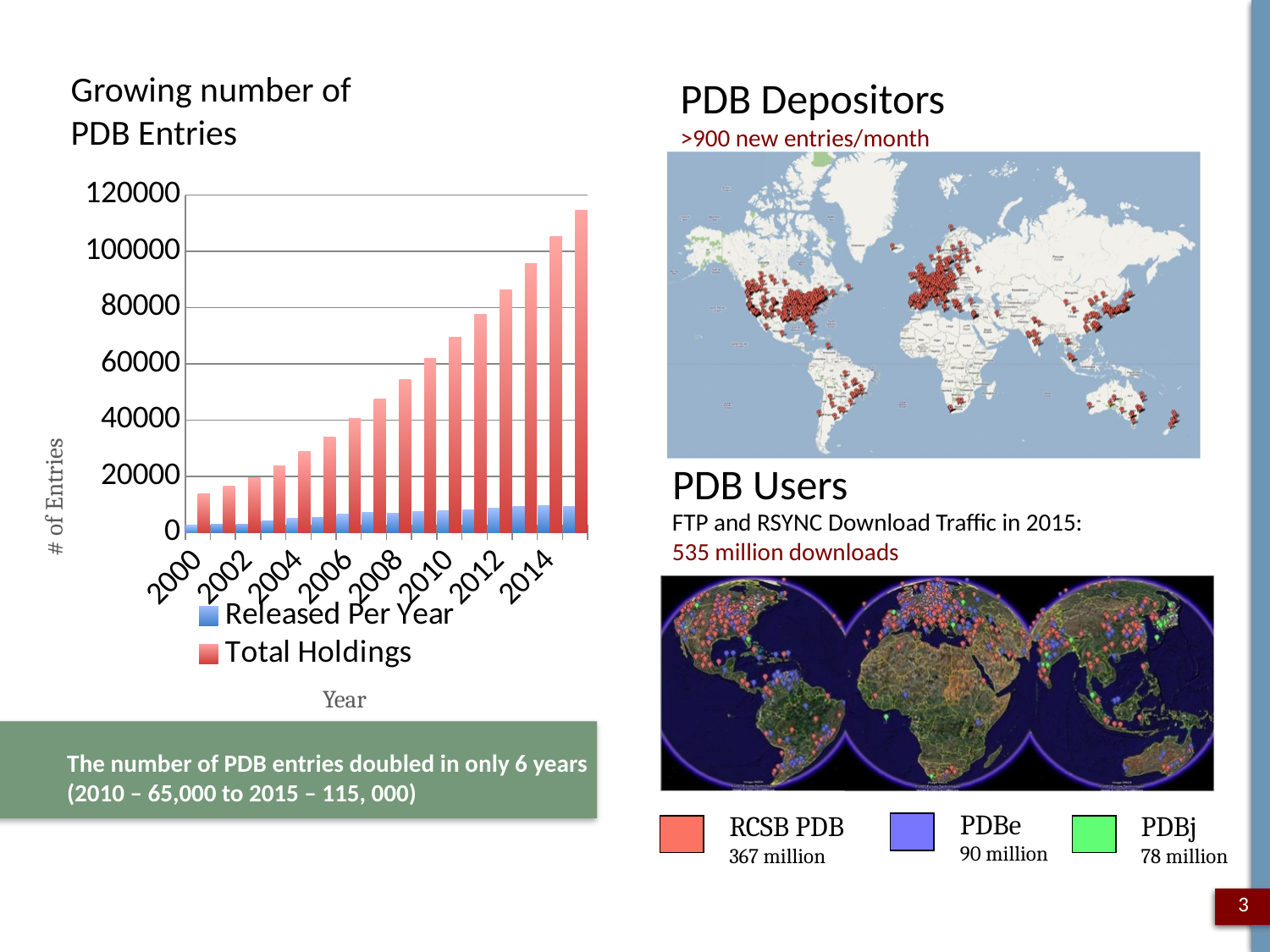
What kind of chart is used in 'Growing number of PDB Entries'? bar chart In the 'Growing number of PDB Entries' chart, is the Total Holdings value for 2010 greater or less than 40000? greater In the 'Growing number of PDB Entries' chart, what colour are the Total Holdings bars? red In the 'Growing number of PDB Entries' chart, is the Released Per Year value for 2014 greater or less than 20000? less In the 'Growing number of PDB Entries' chart, which year has the lowest Total Holdings? 2000 How many series does the legend of the 'Growing number of PDB Entries' chart list? 2 In the 'Growing number of PDB Entries' chart, is the Total Holdings value for 2000 greater or less than 20000? less What is the label on the vertical axis of the 'Growing number of PDB Entries' chart? # of Entries In the 'Growing number of PDB Entries' chart, do the Total Holdings values rise or fall from 2000 to 2015? rise In the 'Growing number of PDB Entries' chart, which is larger: Total Holdings in 2014 or Total Holdings in 2008? 2014 In the 'Growing number of PDB Entries' chart, which year has the highest Total Holdings? 2015